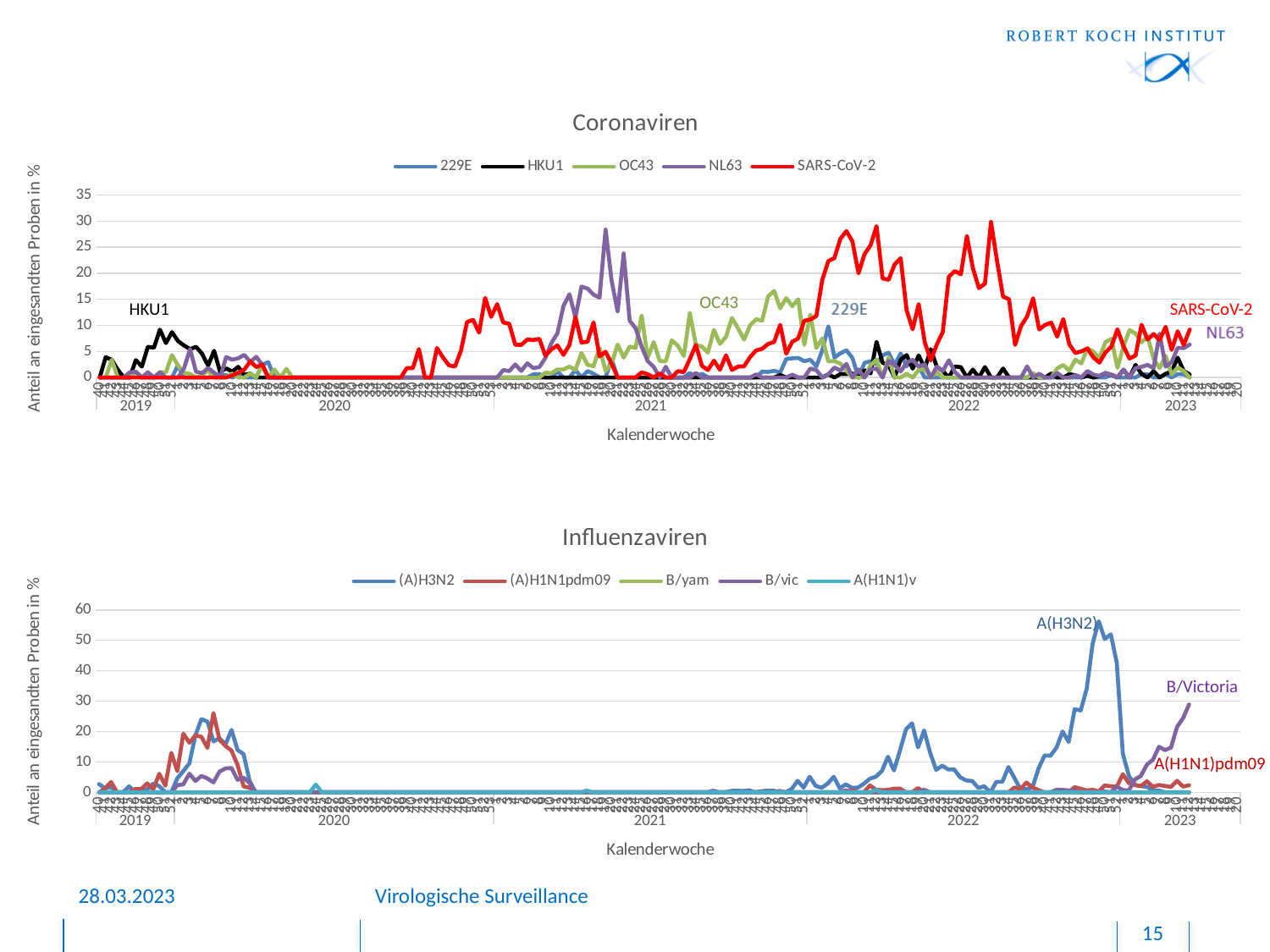
In the Coronaviren chart, is the highest value of SARS-CoV-2 greater or less than 25? greater In the Influenzaviren chart, is the peak value of B/Victoria in 2023 greater or less than 20? greater In the Influenzaviren chart, which series reaches a higher peak, A(H3N2) or B/vic? A(H3N2) What is the y-axis title of the Influenzaviren chart? Anteil an eingesandten Proben in % In the Coronaviren chart, is the peak of HKU1 in 2019 greater or less than 15? less What kind of chart is the Influenzaviren chart? line chart What kind of chart is the Coronaviren chart? line chart How many series does the legend of the Coronaviren chart list? 5 In the Influenzaviren chart, which series reaches the highest peak? (A)H3N2 How many series does the legend of the Influenzaviren chart list? 5 What is the x-axis title of the Coronaviren chart? Kalenderwoche